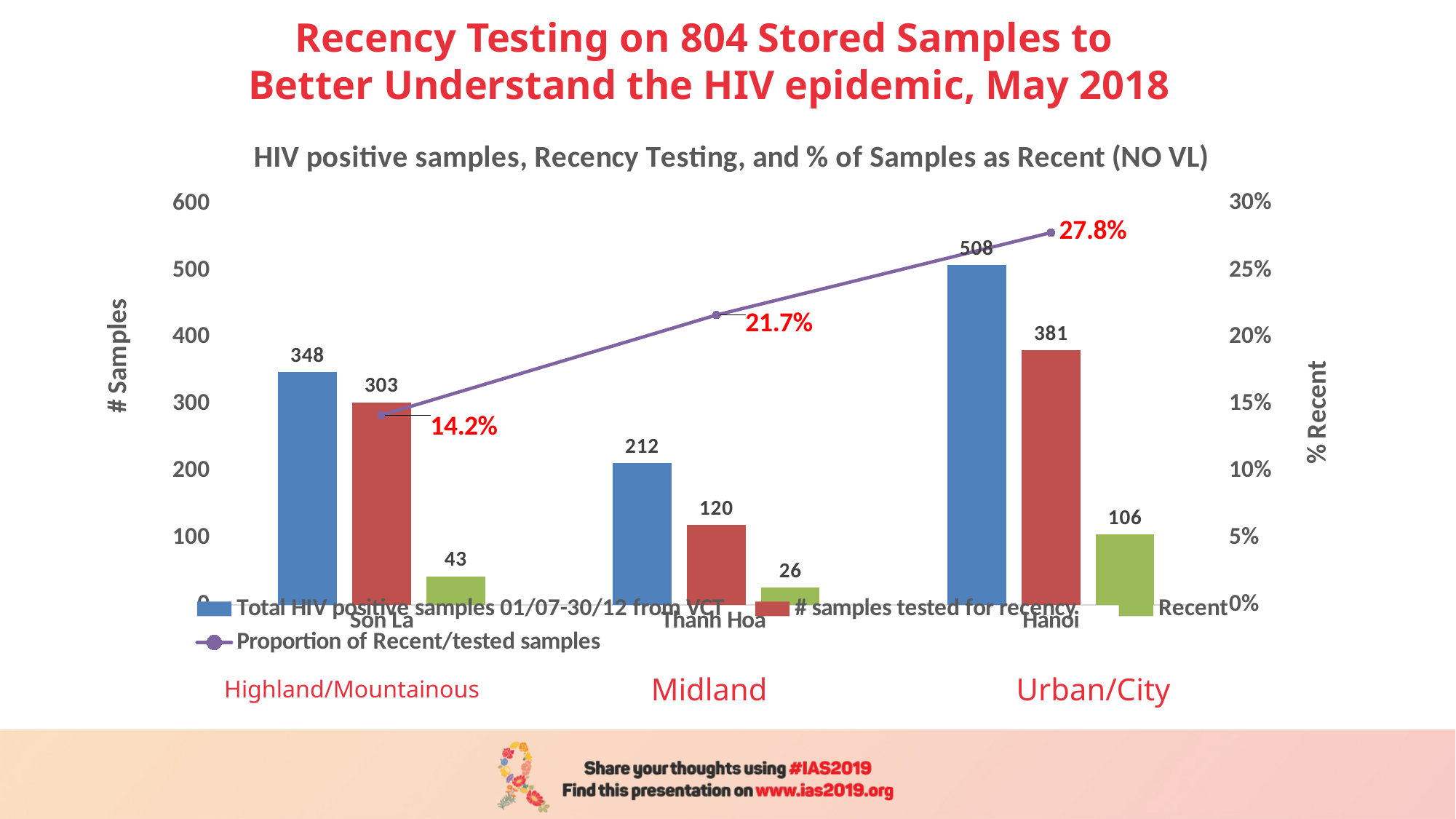
What is the Recent value for Thanh Hoa? 26 What is the difference between the total HIV positive samples for Hanoi and Son La? 160 How many samples were tested for recency in Son La? 303 What is the number of total HIV positive samples for Hanoi? 508 How many series does the legend list? 4 How many provinces are shown on the x axis? 3 What is the label of the right-hand vertical axis? % Recent Which province has the lowest number of samples tested for recency? Thanh Hoa Which province has the highest number of total HIV positive samples? Hanoi What is the proportion of Recent/tested samples for Hanoi? 27.8% Does the proportion of Recent/tested samples rise or fall from Son La to Hanoi? rise Which is larger: the Recent value for Hanoi or for Son La? Hanoi